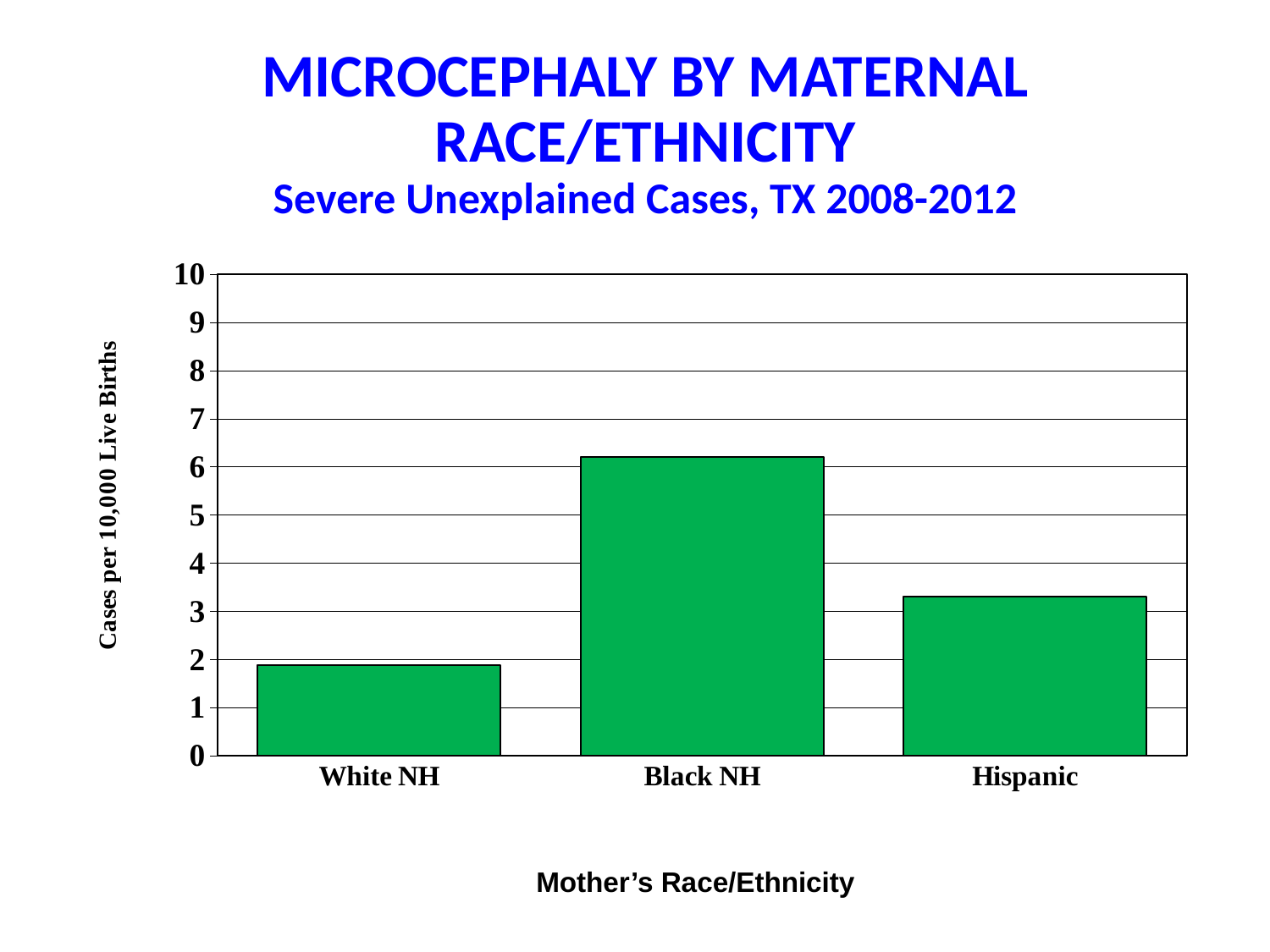
Which has a higher rate of cases, Black NH or Hispanic? Black NH Which mother's race/ethnicity has the highest rate of severe unexplained microcephaly cases? Black NH How many race/ethnicity categories are shown on the chart? 3 Is the rate for Hispanic greater or less than 3 cases per 10,000 live births? greater What is the label of the x axis? Mother's Race/Ethnicity Is the rate for Hispanic greater or less than 4 cases per 10,000 live births? less What is the label of the y axis? Cases per 10,000 Live Births What kind of chart is shown on the slide? bar chart Which mother's race/ethnicity has the lowest rate of severe unexplained microcephaly cases? White NH Is the rate for White NH greater or less than 2 cases per 10,000 live births? less Which has a higher rate of cases, Hispanic or White NH? Hispanic